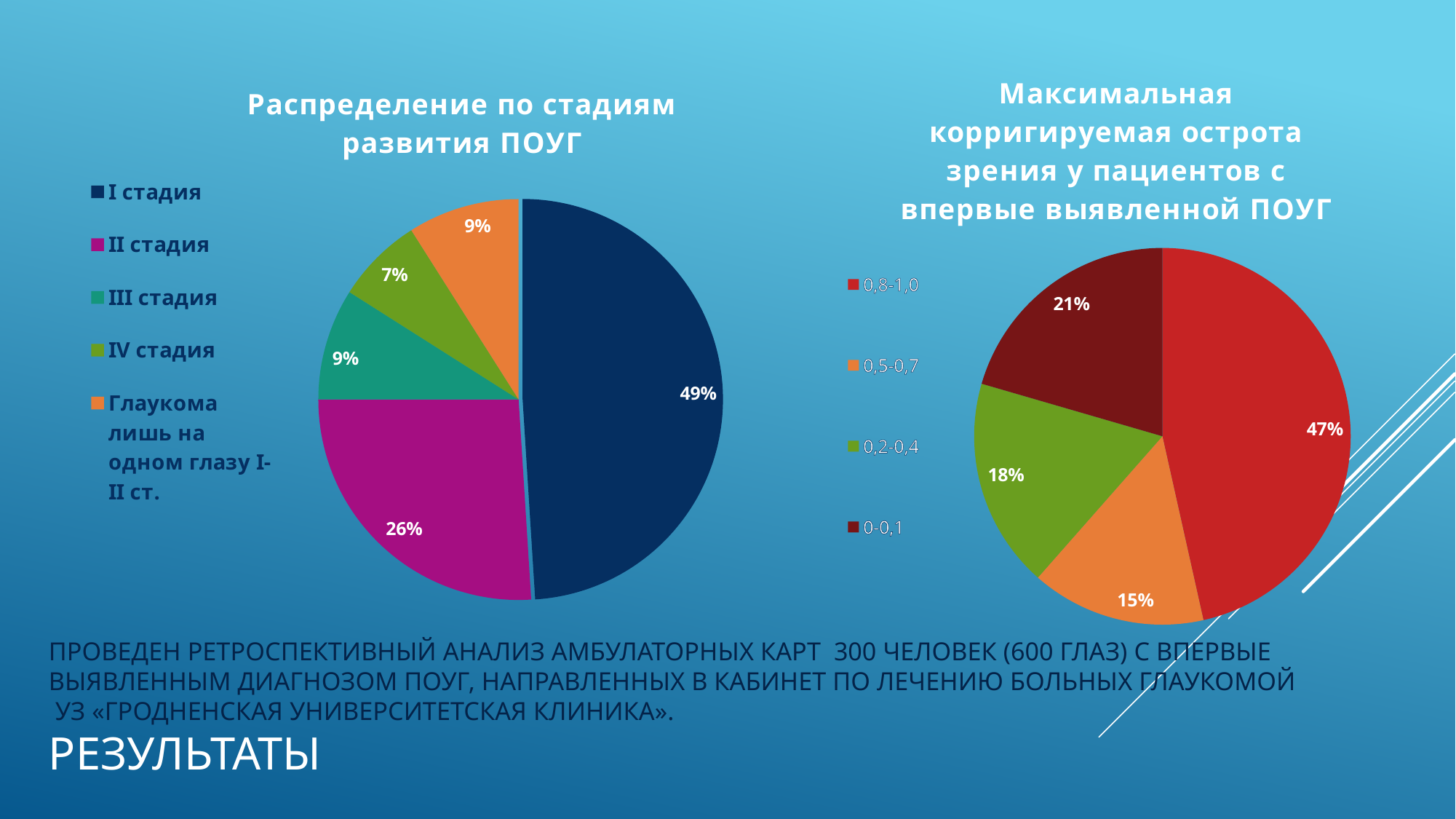
How many categories does the legend of the right chart 'Максимальная корригируемая острота зрения у пациентов с впервые выявленной ПОУГ' list? 4 What type of chart is the right chart 'Максимальная корригируемая острота зрения у пациентов с впервые выявленной ПОУГ'? Pie chart In the left chart 'Распределение по стадиям развития ПОУГ', which category has the smallest slice? IV стадия In the right chart 'Максимальная корригируемая острота зрения у пациентов с впервые выявленной ПОУГ', which category has the smallest slice? 0,5-0,7 In the left chart 'Распределение по стадиям развития ПОУГ', what share is labelled for I стадия? 49% How many categories does the legend of the left chart 'Распределение по стадиям развития ПОУГ' list? 5 In the right chart 'Максимальная корригируемая острота зрения у пациентов с впервые выявленной ПОУГ', what share is labelled for 0-0,1? 21% In the left chart 'Распределение по стадиям развития ПОУГ', which category has the largest slice? I стадия In the right chart 'Максимальная корригируемая острота зрения у пациентов с впервые выявленной ПОУГ', what share is labelled for 0,8-1,0? 47% In the left chart 'Распределение по стадиям развития ПОУГ', what share is labelled for II стадия? 26% In the right chart 'Максимальная корригируемая острота зрения у пациентов с впервые выявленной ПОУГ', which is larger: the share for 0,2-0,4 or the share for 0-0,1? 0-0,1 In the left chart 'Распределение по стадиям развития ПОУГ', what is the difference between the shares for I стадия and II стадия? 23%